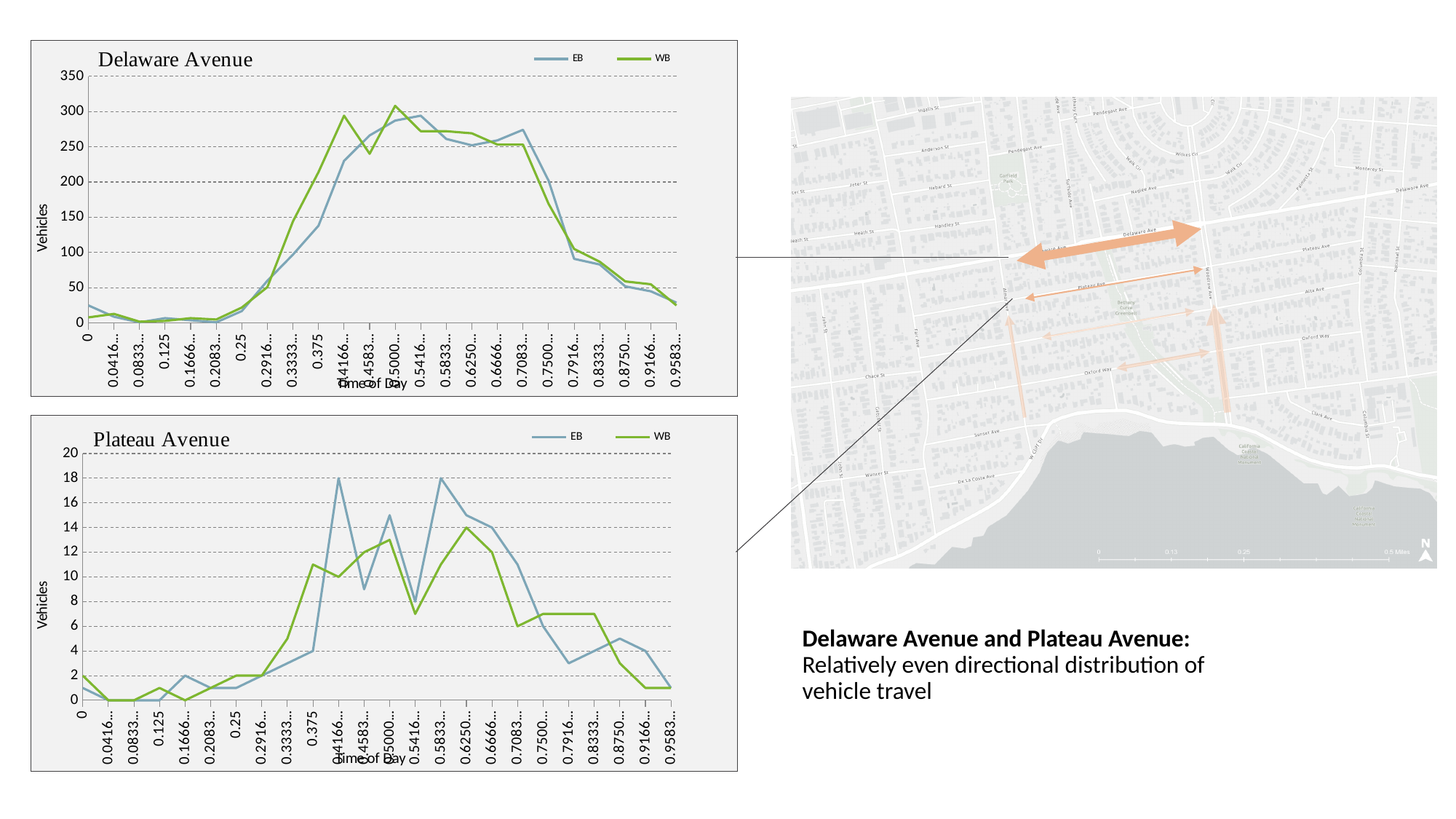
How many series does the legend of the Plateau Avenue chart list? 2 In the Plateau Avenue chart, which series reaches the highest peak value? EB In the Delaware Avenue chart, is the EB value at 0.7916... greater or less than 100? less In the Plateau Avenue chart, which series is higher at 0.375, EB or WB? WB What are the two series named in the legend of the Delaware Avenue chart? EB and WB In the Delaware Avenue chart, is the WB value at 0.4166... greater or less than 250? greater What kind of chart is the Delaware Avenue chart? line chart In the Delaware Avenue chart, which series is higher at 0.4166..., EB or WB? WB What is the label on the vertical axis of the Plateau Avenue chart? Vehicles How many time-of-day points are labelled along the x axis of the Delaware Avenue chart? 24 In the Delaware Avenue chart, is the EB value at 0.375 greater or less than 100? greater In the Delaware Avenue chart, do the EB values rise or fall between 0.7083... and 0.9583...? fall